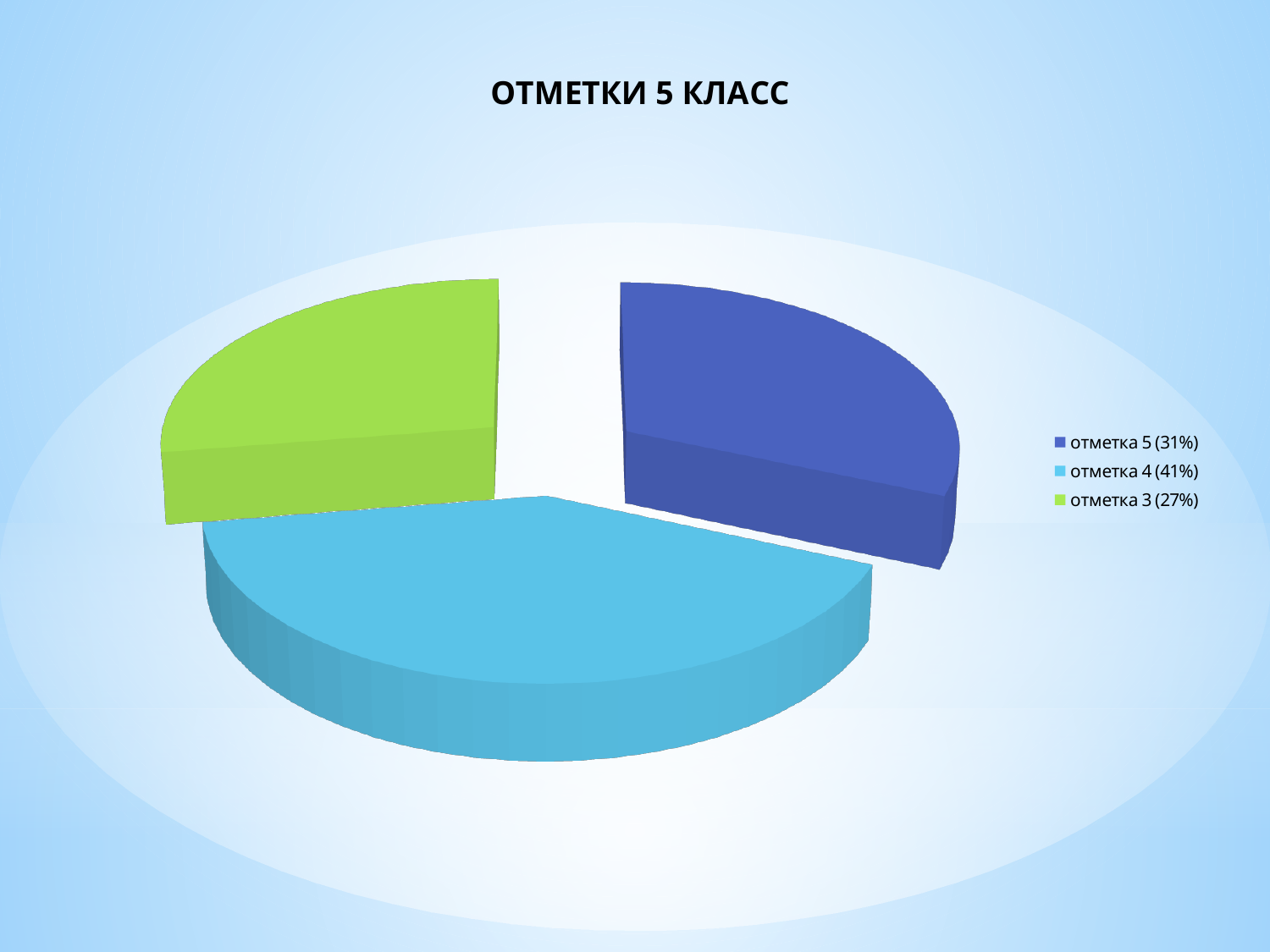
What share of the pie does "отметка 3" take? 27% What colour is the slice for "отметка 3"? green Which category has the smallest slice of the pie? отметка 3 How many slices does the pie chart have? 3 What kind of chart is shown on the slide? pie chart What share of the pie does "отметка 5" take? 31% Which category has the largest slice of the pie? отметка 4 What share of the pie does "отметка 4" take? 41% What is the title of the chart? ОТМЕТКИ 5 КЛАСС How many entries does the legend list? 3 What is the difference in percentage points between the shares of "отметка 4" and "отметка 5"? 10 Which is larger, the share for "отметка 5" or the share for "отметка 3"? отметка 5